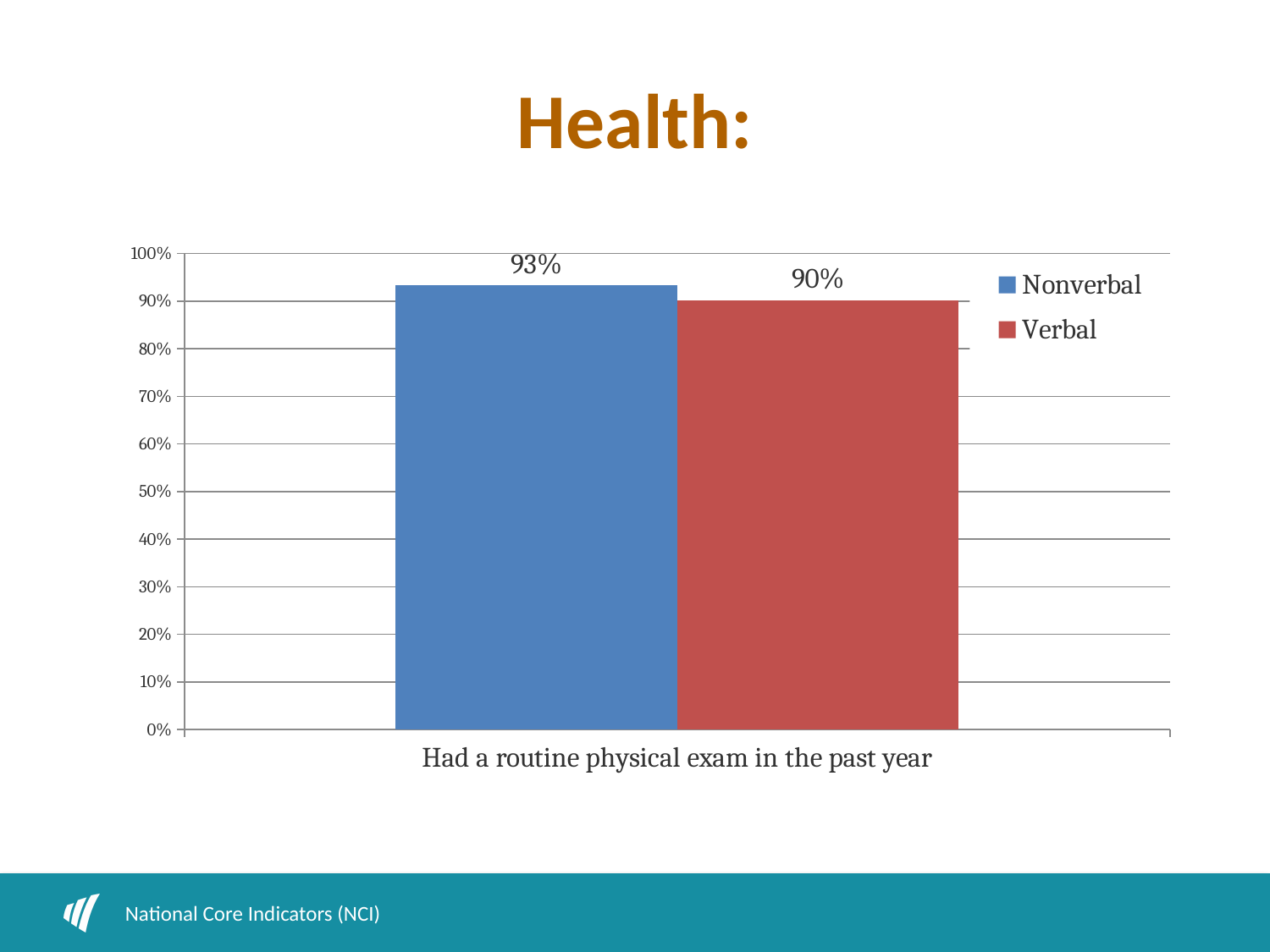
How many series does the legend list? 2 What is the difference in percentage points between the Nonverbal and Verbal values? 3 percentage points Is the value for Nonverbal larger or smaller than the value for Verbal? larger What percentage of the Nonverbal group had a routine physical exam in the past year? 93% What percentage of the Verbal group had a routine physical exam in the past year? 90% Is the value for Verbal greater or less than 80%? greater What colour is the bar for the Verbal series? red Is the value for Nonverbal greater or less than 100%? less What kind of chart is shown on the slide? bar chart What is the category label shown on the x axis of the chart? Had a routine physical exam in the past year Which series has the lower value for having had a routine physical exam in the past year? Verbal Which series has the higher value for having had a routine physical exam in the past year? Nonverbal